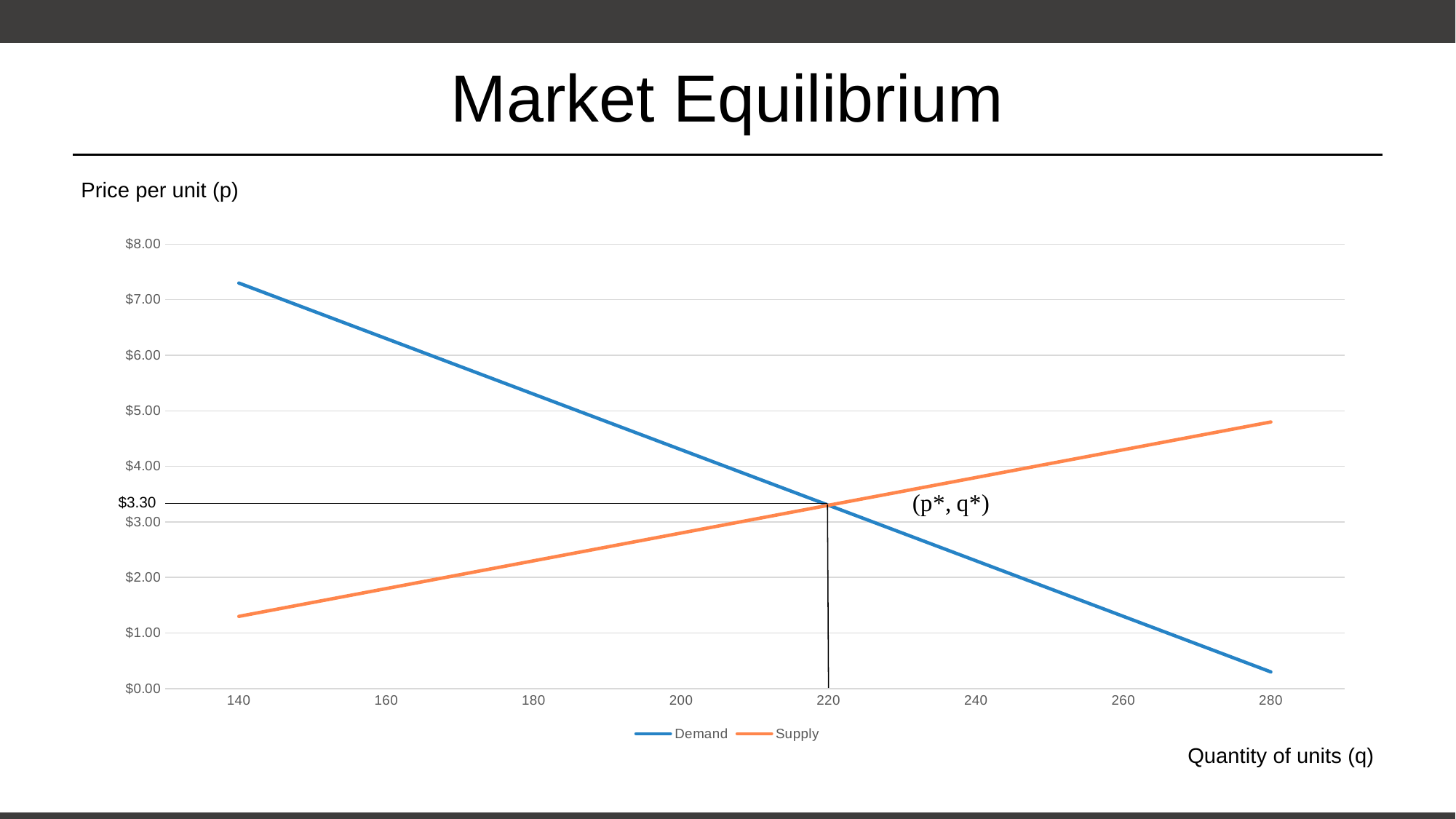
Does the Demand line rise or fall as quantity increases along the x axis? fall Is the Supply value at quantity 140 greater or less than $2.00? less At quantity 160, which line is higher, Demand or Supply? Demand At what quantity do the Demand and Supply lines intersect? 220 Is the Demand value at quantity 280 greater or less than $1.00? less How many series does the legend list? 2 Does the Supply line rise or fall as quantity increases along the x axis? rise What are the two series named in the legend? Demand and Supply What kind of chart is shown on the slide? line chart What is the price at which the Demand and Supply lines intersect? $3.30 At quantity 260, which line is higher, Demand or Supply? Supply Is the Demand value at quantity 140 greater or less than $7.00? greater